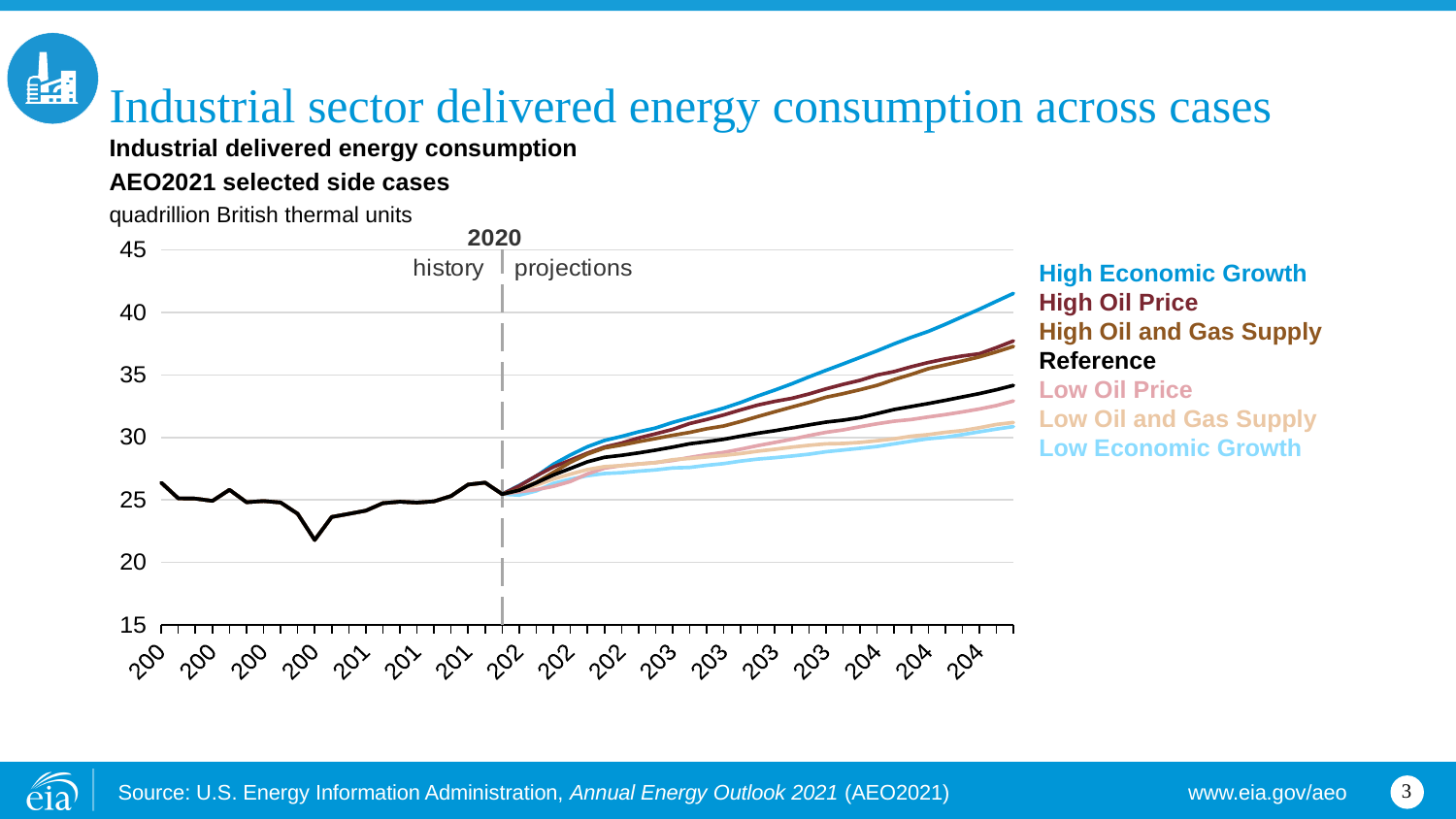
What year separates history from projections on the chart? 2020 Is the value for the High Economic Growth case at the end of the projection period greater or less than 40? greater What unit is the y axis measured in? quadrillion British thermal units Is the lowest point of the history line (around 2009) greater or less than 25? less What kind of chart is shown on the slide? line chart How many series (cases) does the legend list? 7 Which case has the highest industrial delivered energy consumption at the end of the projection period? High Economic Growth Is the value for the Low Economic Growth case at the end of the projection period greater or less than 30? greater Which is larger at the end of the projection period, the High Economic Growth case or the Reference case? High Economic Growth Do the projected values rise or fall over the projection period? rise